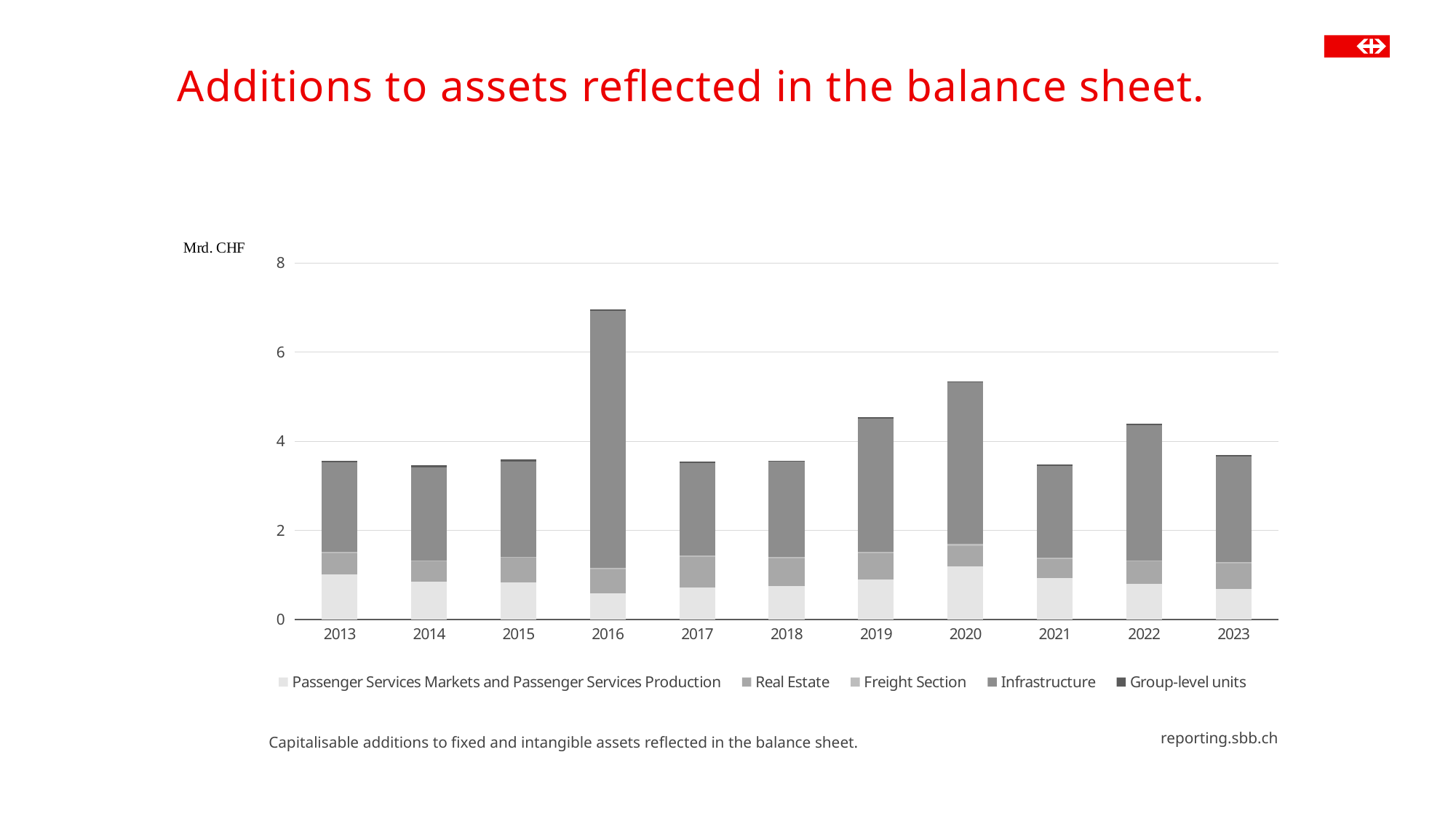
What kind of chart is shown on the slide? Stacked bar chart Which year has the larger total, 2019 or 2020? 2020 Is the total value for 2023 greater or less than 4? less Which year has the highest total additions to assets? 2016 What is the title of the slide? Additions to assets reflected in the balance sheet. Is the total value for 2020 greater or less than 4? greater Is the total value for 2016 greater or less than 6? greater How many series does the chart's legend list? 5 Do the total values rise or fall from 2016 to 2017? fall What unit is shown on the y axis of the chart? Mrd. CHF How many years are shown on the x axis of the chart? 11